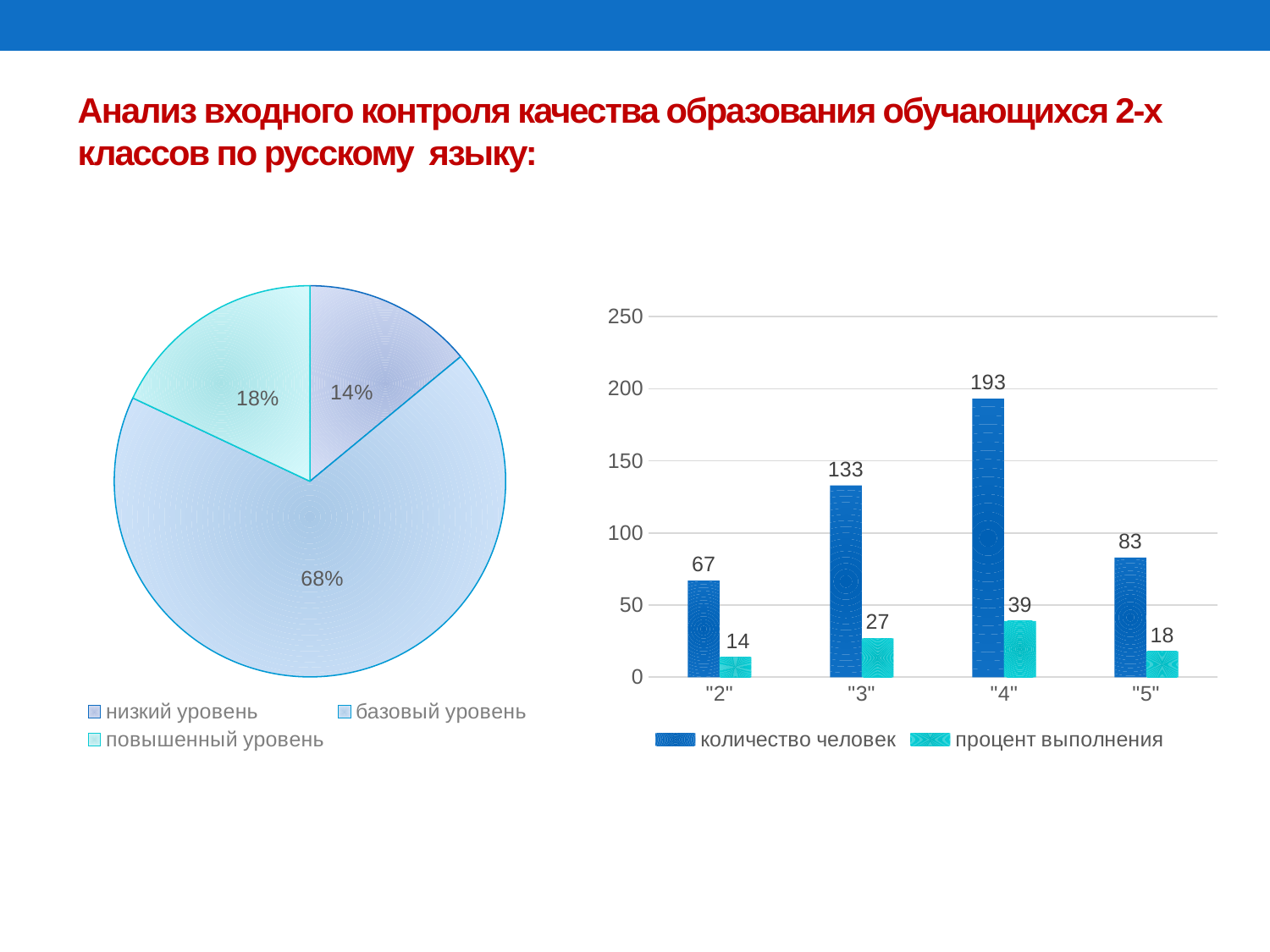
In the bar chart on the right, what is the value of процент выполнения for "3"? 27 In the bar chart on the right, what is the value of количество человек for "4"? 193 In the bar chart on the right, what is the difference between количество человек for "4" and for "3"? 60 In the bar chart on the right, which category has the lowest value for процент выполнения? "2" What kind of chart is on the right side of the slide? bar chart In the bar chart on the right, how many series does the legend list? 2 In the pie chart on the left, how many slices are there? 3 In the bar chart on the right, how many categories are shown on the x axis? 4 In the bar chart on the right, which is larger: количество человек for "5" or for "2"? "5" In the bar chart on the right, which category has the highest value for количество человек? "4" In the pie chart on the left, what share does the largest slice have? 68% In the pie chart on the left, what share is shown for повышенный уровень? 18%